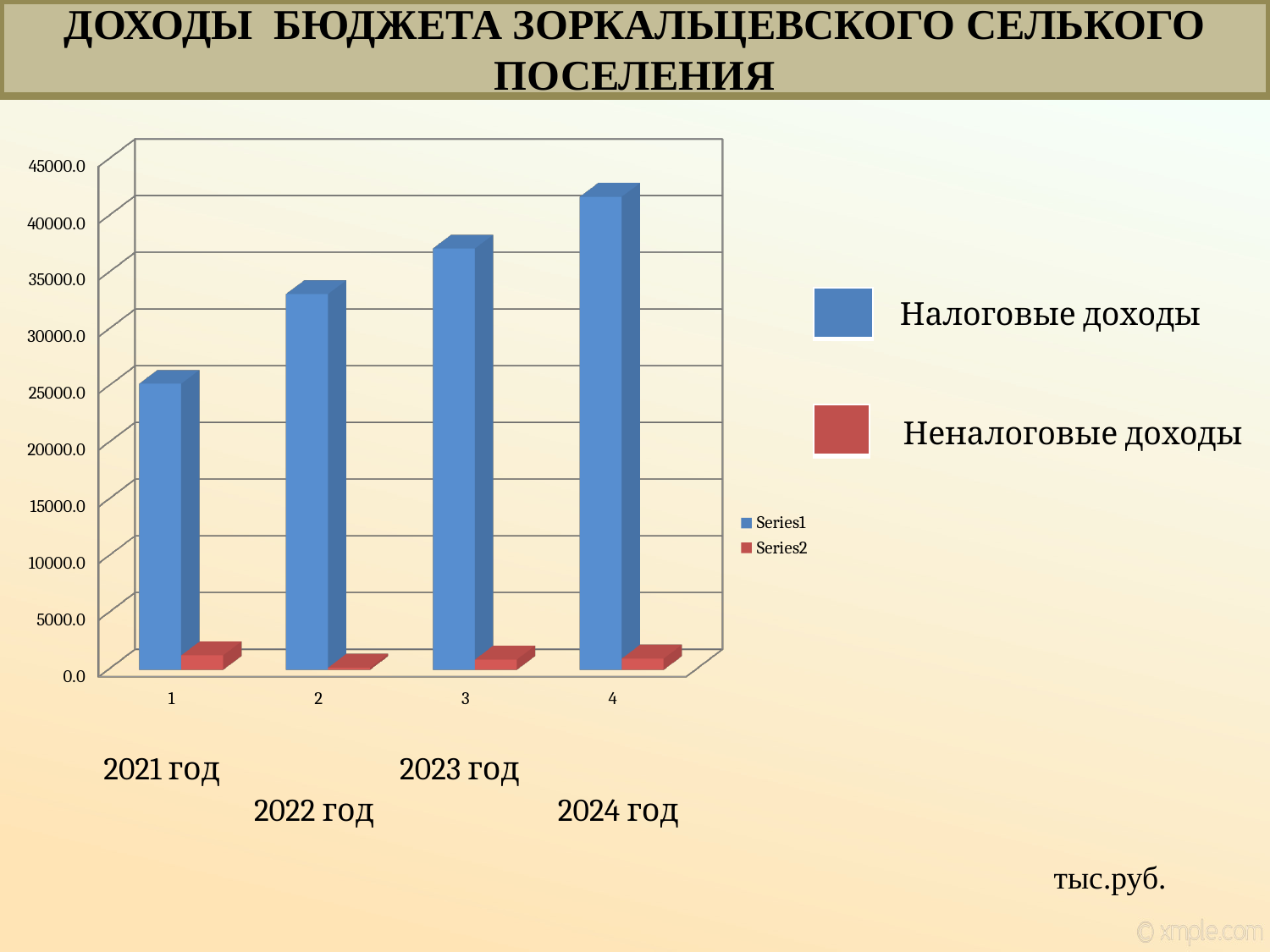
Which is larger for Series1: the value for category 3 or the value for category 2? category 3 Is the Series1 value for category 4 greater or less than 40000.0? greater Is the Series1 value for category 2 greater or less than 30000.0? greater Is the Series1 value for category 1 greater or less than 30000.0? less Do the Series1 (Налоговые доходы) values rise or fall from category 1 to category 4? rise What kind of chart is shown on the slide? bar chart What colour represents Налоговые доходы in the chart? blue How many categories are plotted along the x axis of the chart? 4 Which category has the highest value for Series1 (Налоговые доходы)? 4 How many series does the chart's legend list? 2 Which category has the lowest value for Series1 (Налоговые доходы)? 1